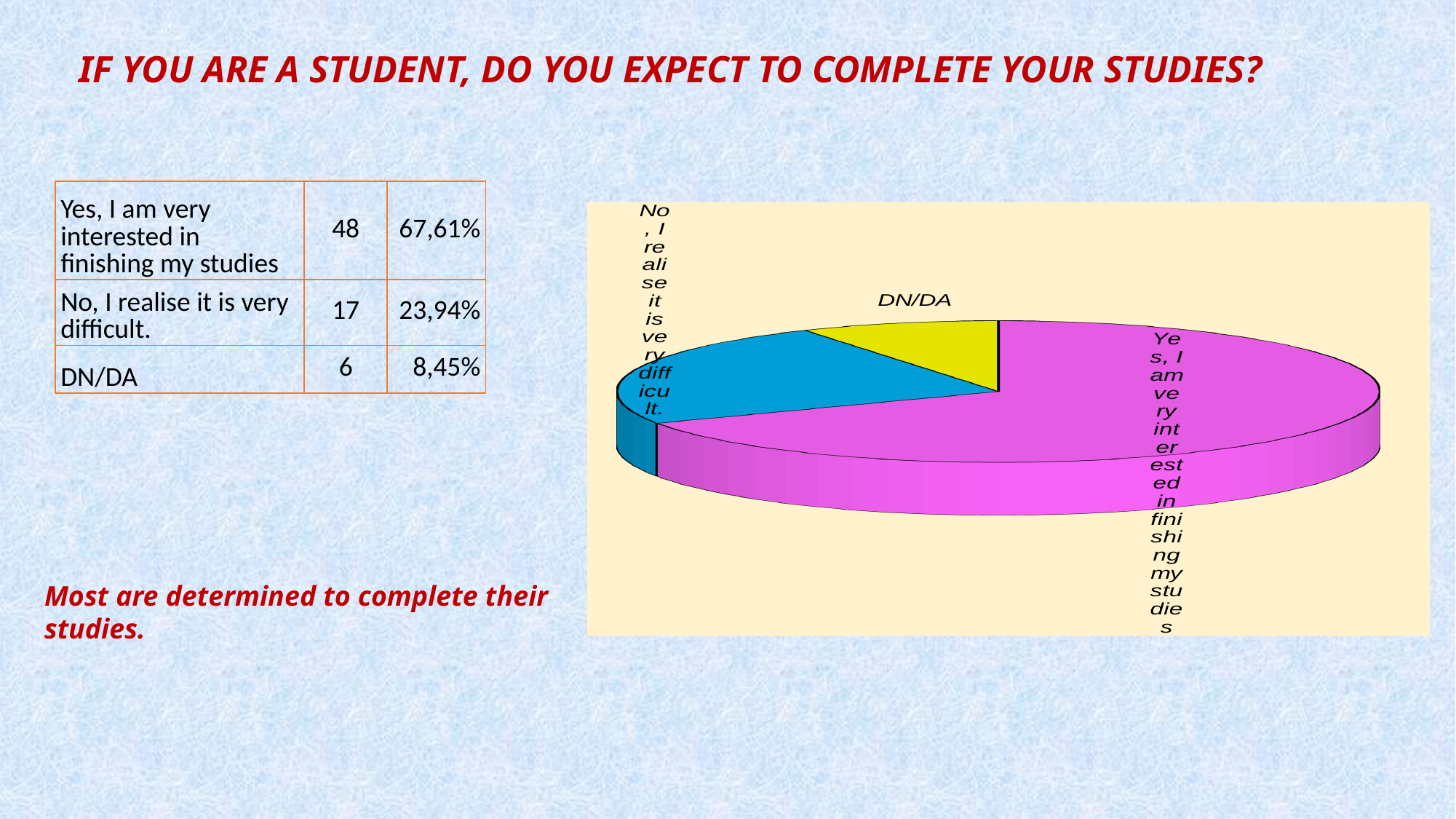
Which slice of the pie chart is the smallest? DN/DA What kind of chart is shown on the slide? pie chart How many slices does the pie chart have? 3 What share of the pie does the 'Yes, I am very interested in finishing my studies' slice represent, according to the slide? 67,61% How many respondents are in the 'No, I realise it is very difficult.' slice, according to the slide? 17 How many respondents are in the DN/DA slice, according to the slide? 6 What share of the pie does the DN/DA slice represent, according to the slide? 8,45% Which slice is larger: 'No, I realise it is very difficult.' or DN/DA? No, I realise it is very difficult. What is the difference in respondent count between the 'Yes, I am very interested in finishing my studies' slice and the 'No, I realise it is very difficult.' slice? 31 What colour is the DN/DA slice in the pie chart? yellow Which slice of the pie chart is the largest? Yes, I am very interested in finishing my studies What share of the pie does the 'No, I realise it is very difficult.' slice represent, according to the slide? 23,94%